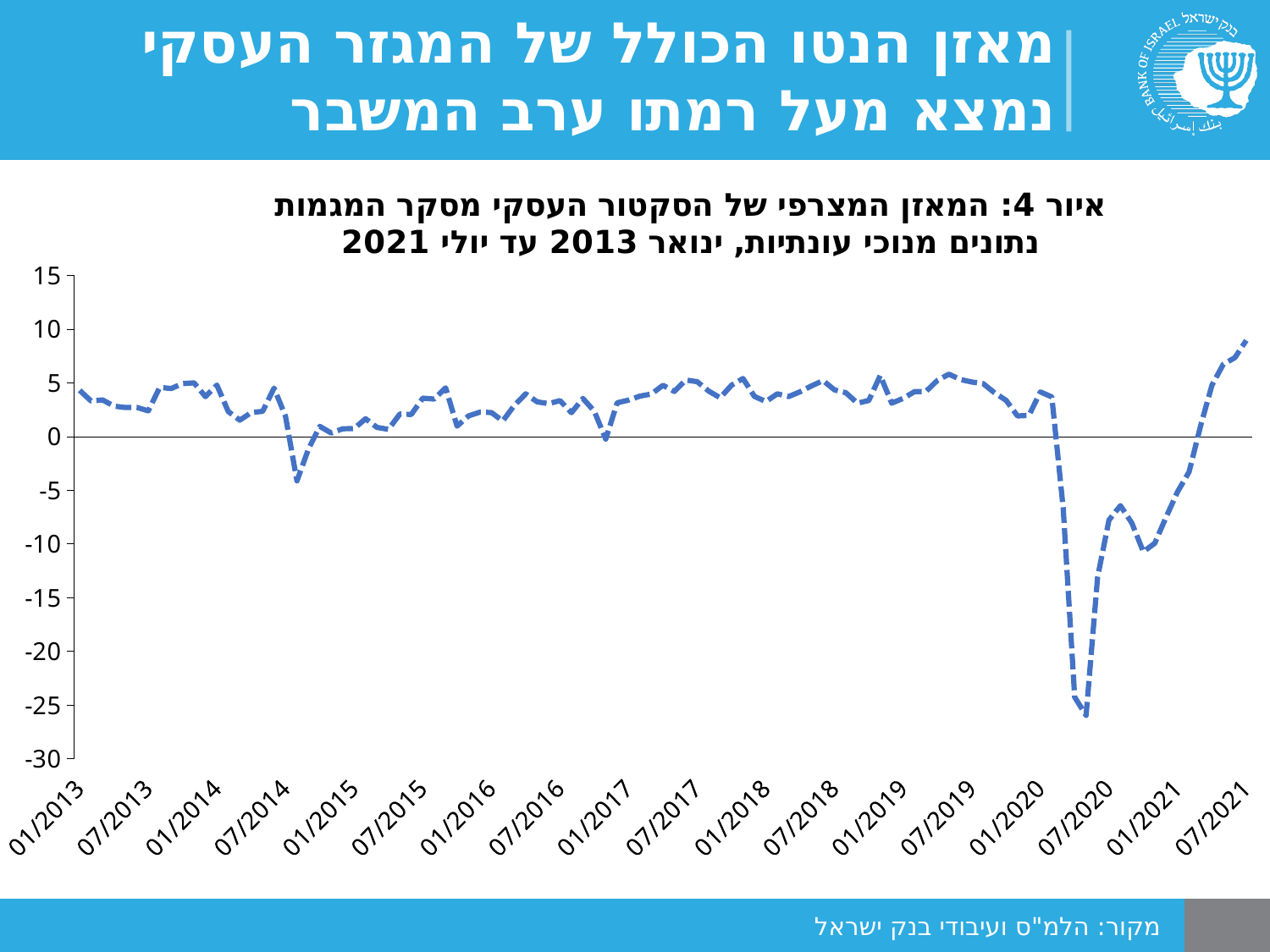
Which is larger, the value at 01/2013 or the value at 07/2020? 01/2013 Which is larger, the value at 07/2021 or the value at 01/2021? 07/2021 What is the title of the chart (the figure caption above the plot)? איור 4: המאזן המצרפי של הסקטור העסקי מסקר המגמות נתונים מנוכי עונתיות, ינואר 2013 עד יולי 2021 Is the value at 01/2019 greater or less than 0? greater Is the value at 01/2021 greater or less than 0? less Does the line rise or fall between 07/2020 and 07/2021? rise In which year does the line reach its lowest value? 2020 Is the lowest point of the line, reached in 2020, greater or less than -20? less How many date labels are shown on the x axis? 18 What kind of chart is shown on the slide? line chart What is the source stated at the bottom of the slide? הלמ"ס ועיבודי בנק ישראל